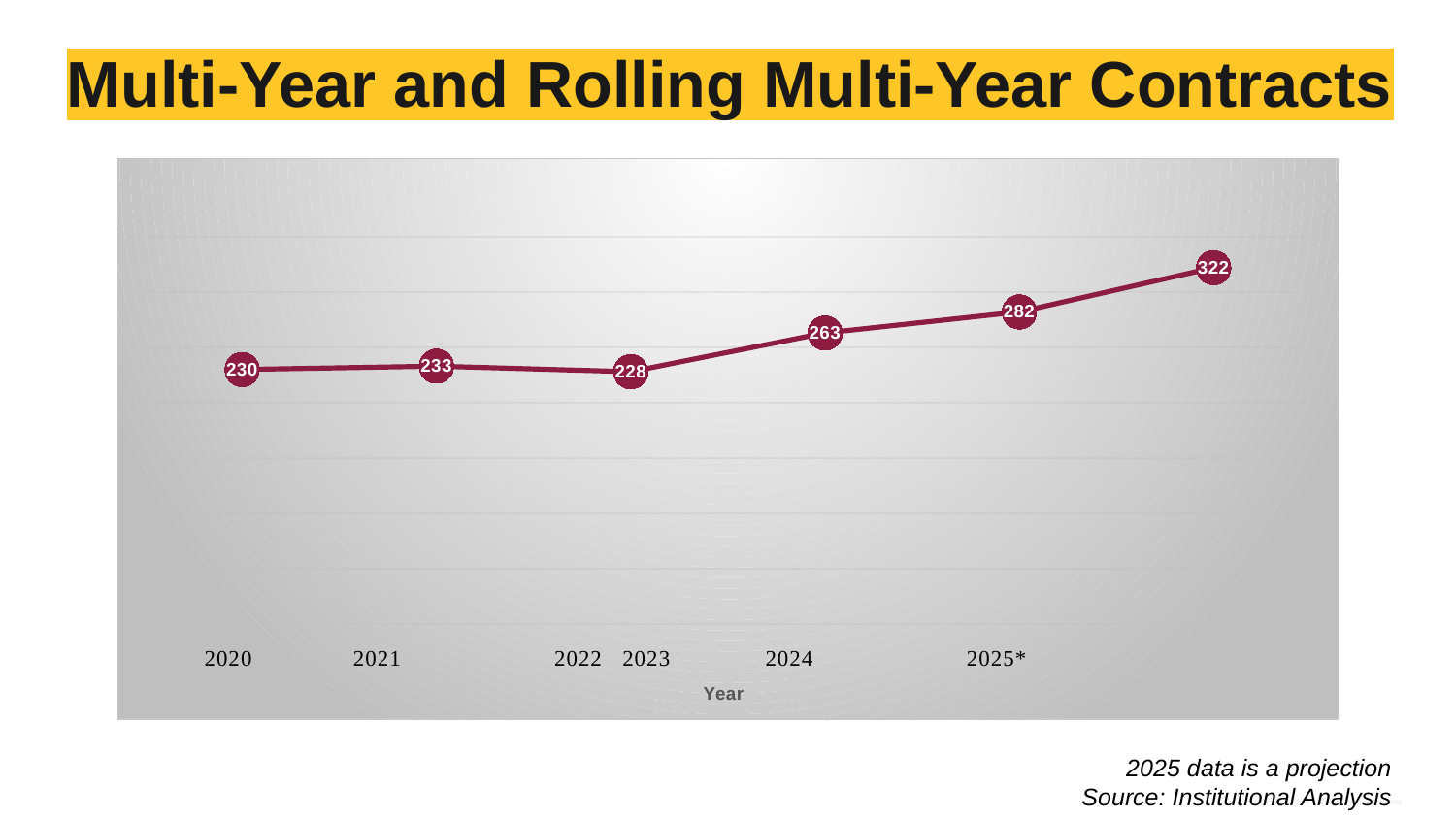
What is the difference between the values for 2025* and 2024? 40 Which year has the highest value? 2025* Which is larger, the value for 2021 or the value for 2022? 2021 What kind of chart is shown on the slide? Line chart Do the values generally rise or fall from 2022 to 2025*? Rise Which year has the lowest value? 2022 What is the value for 2023? 263 What is the value for 2025*? 322 What is the value for 2020? 230 How many data points are plotted on the chart? 6 What is the difference between the values for 2023 and 2022? 35 What is the label of the x axis? Year